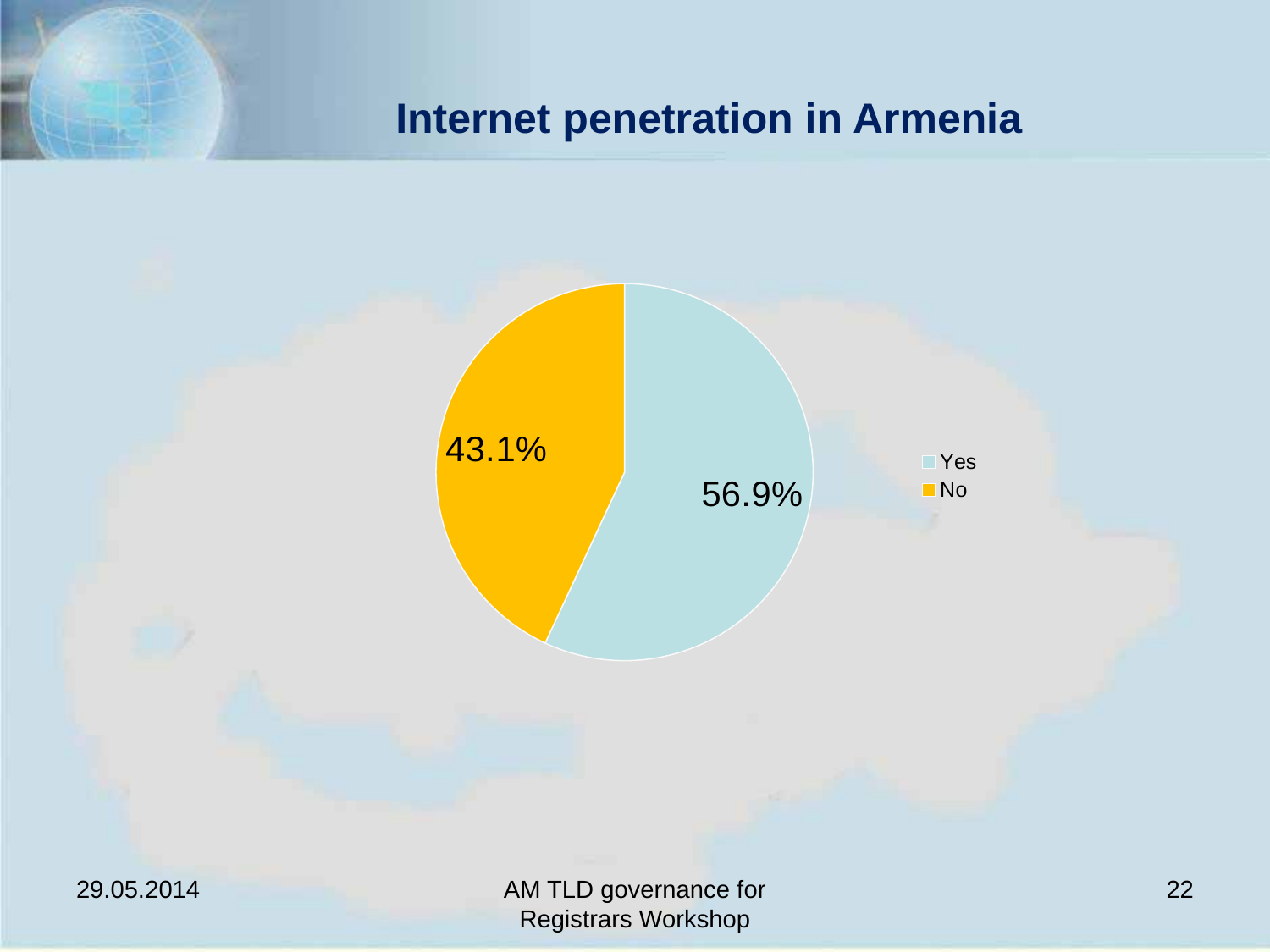
Which slice is the largest in the pie chart? Yes What kind of chart is shown on the slide? Pie chart Which is larger, the "Yes" slice or the "No" slice? Yes Which slice is the smallest in the pie chart? No What share of the pie does the "No" slice represent? 43.1% Is the "Yes" slice greater or less than 50% of the pie? greater What is the difference in percentage points between the "Yes" and "No" slices? 13.8 How many slices does the pie chart have? 2 How many entries does the legend list? 2 What share of the pie does the "Yes" slice represent? 56.9% What is the title of the slide containing the chart? Internet penetration in Armenia What colour is the "No" slice in the pie chart? Orange